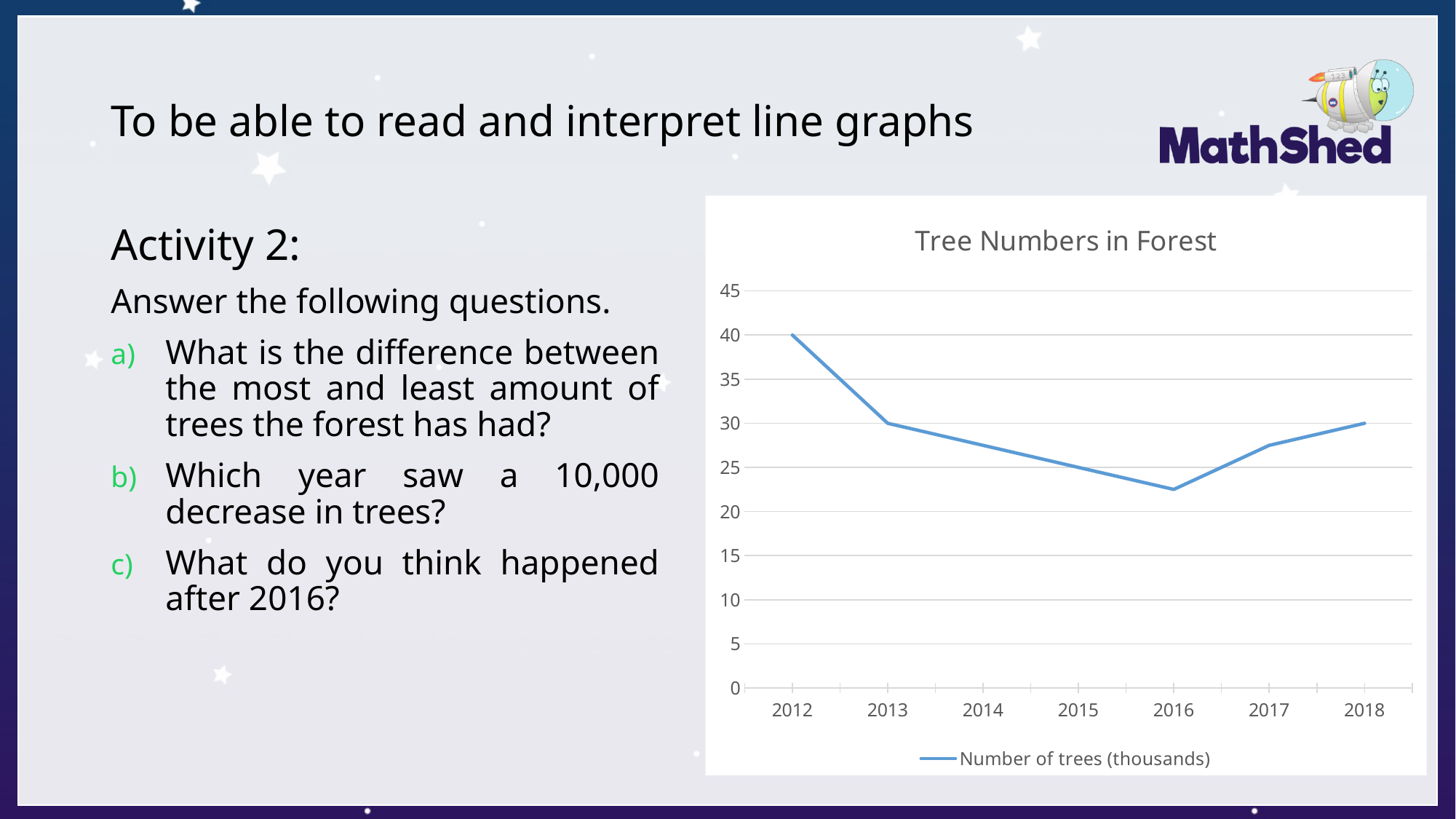
What type of chart is shown on the slide? Line chart Is the value for 2016 greater or less than 25? less What is the legend entry for the plotted series? Number of trees (thousands) What is the title of the chart? Tree Numbers in Forest What is the number of trees (thousands) in 2013? 30 What is the number of trees (thousands) in 2018? 30 What is the difference in number of trees (thousands) between 2012 and 2013? 10 How many series does the legend list? 1 How many years are plotted on the x axis? 7 Which year has the lowest number of trees? 2016 What is the number of trees (thousands) in 2012? 40 Which year has the highest number of trees? 2012